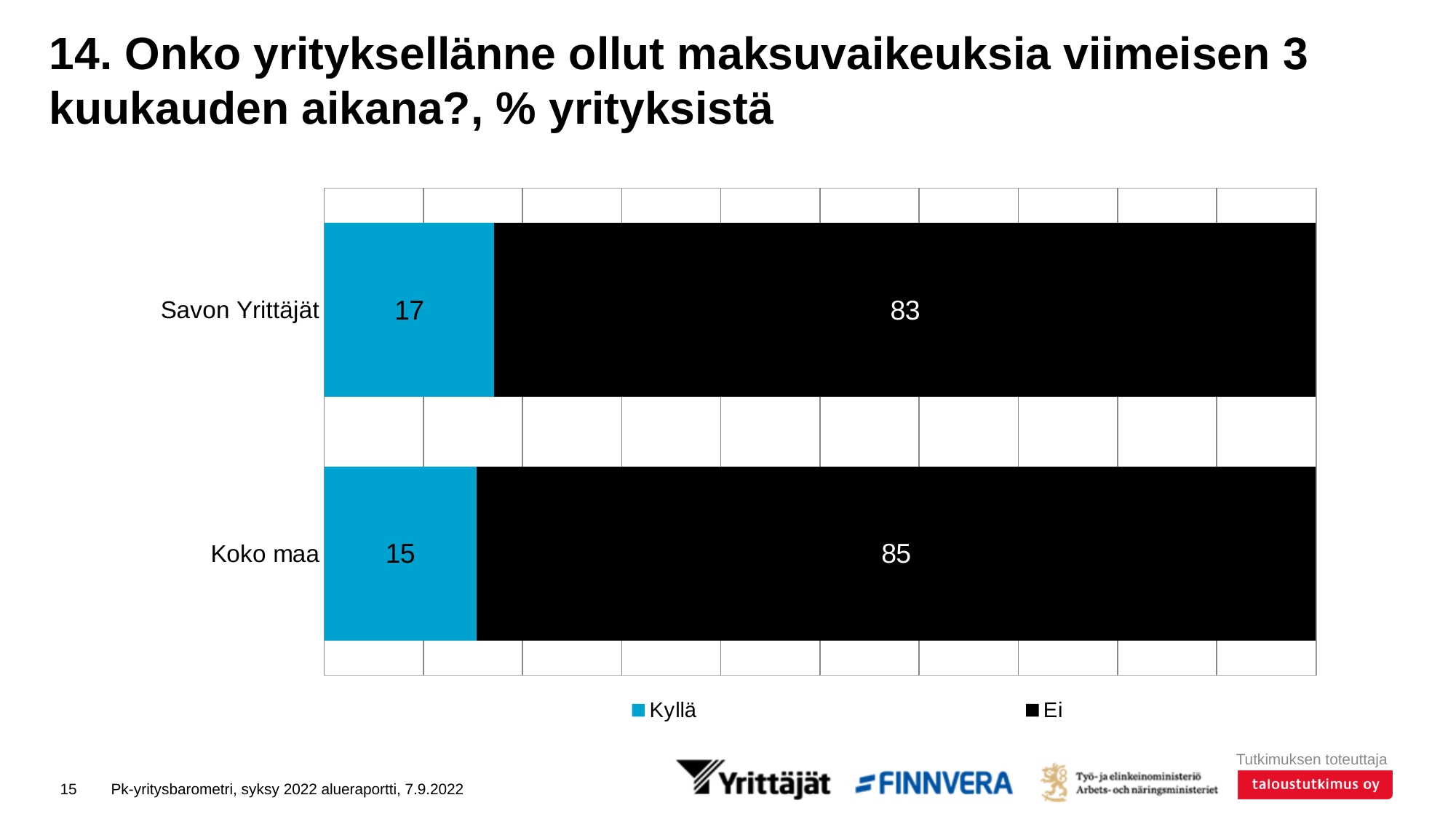
How many series does the legend list? 2 What is the value for Ei for Savon Yrittäjät? 83 How many categories are shown on the chart? 2 What is the value for Kyllä for Savon Yrittäjät? 17 What is the value for Kyllä for Koko maa? 15 What kind of chart is shown on the slide? Stacked bar chart What is the total of the stacked bar for Savon Yrittäjät? 100 What is the difference between the Kyllä values for Savon Yrittäjät and Koko maa? 2 Which category has the lowest Ei value? Savon Yrittäjät What is the value for Ei for Koko maa? 85 Which category has the higher Kyllä value, Savon Yrittäjät or Koko maa? Savon Yrittäjät What is the difference between the Ei values for Koko maa and Savon Yrittäjät? 2